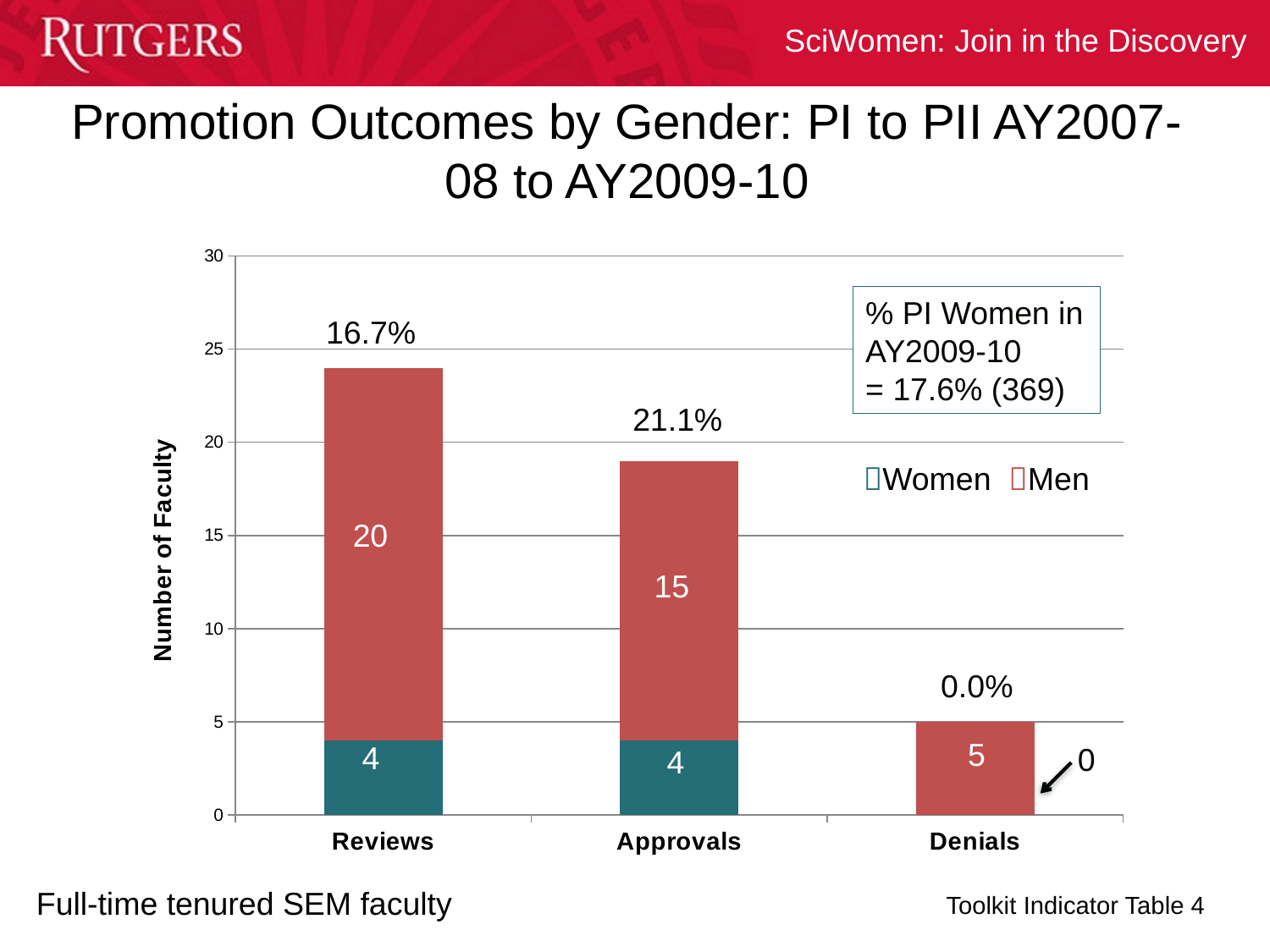
Is the number of Men for Approvals greater or less than the number of Men for Denials? greater How many series does the legend list? 2 What type of chart is shown on the slide? stacked bar chart How many Men are shown for Reviews? 20 How many Men are shown for Denials? 5 What percentage label is shown above the Approvals bar? 21.1% What is the total number of faculty in the Approvals bar? 19 What is the total number of faculty in the Reviews bar? 24 How many Women are shown for Denials? 0 How many Women are shown for Approvals? 4 Which category has the lowest total number of faculty? Denials What is the difference between the number of Men and Women for Reviews? 16